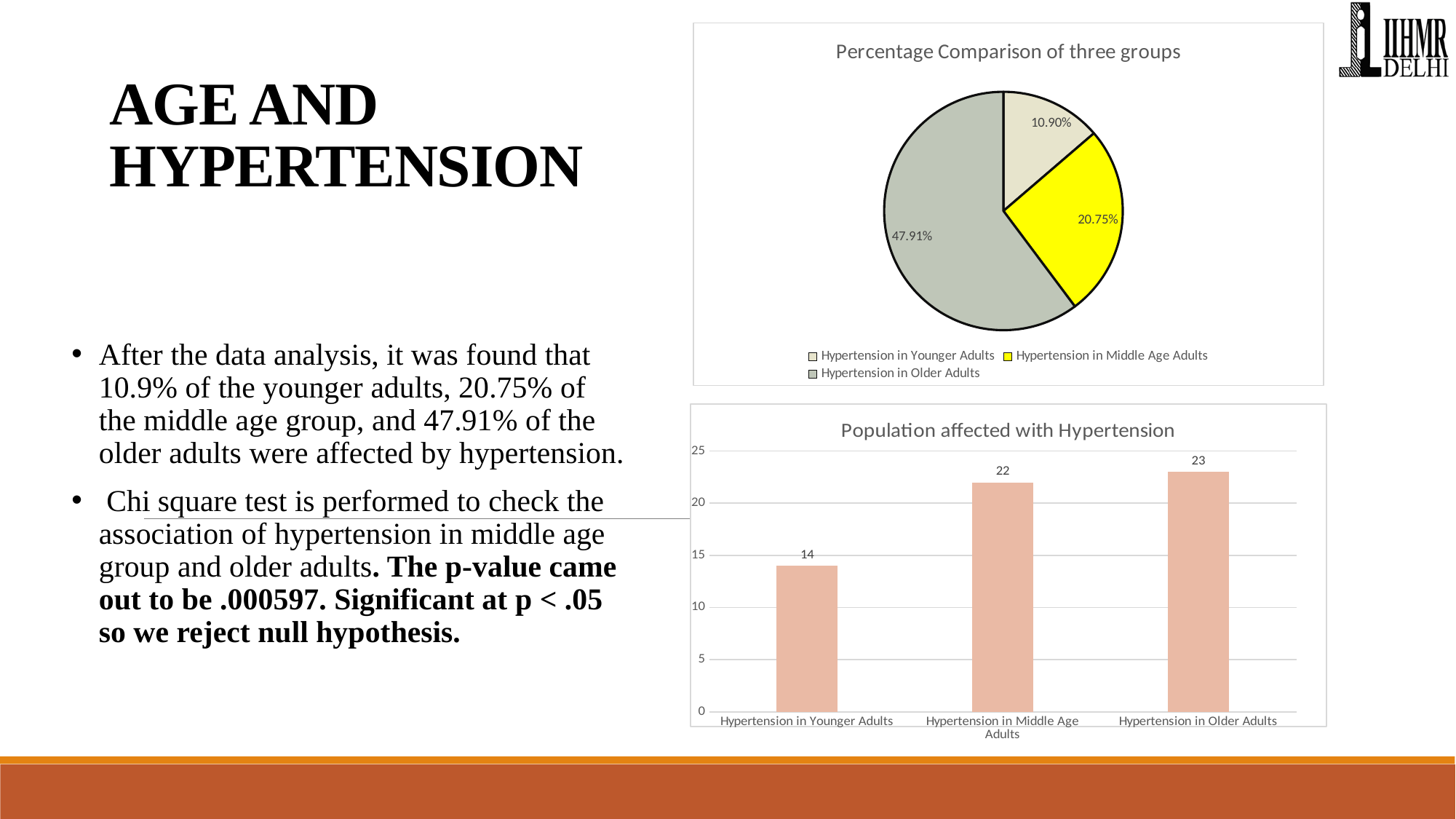
In the 'Population affected with Hypertension' chart, what is the value for Hypertension in Younger Adults? 14 In the 'Percentage Comparison of three groups' pie chart, how many entries does the legend list? 3 In the 'Percentage Comparison of three groups' pie chart, what percentage is shown for Hypertension in Younger Adults? 10.90% What kind of chart is 'Population affected with Hypertension'? Bar chart In the 'Percentage Comparison of three groups' pie chart, what percentage is shown for Hypertension in Older Adults? 47.91% In the 'Population affected with Hypertension' chart, do the values rise or fall from Younger Adults to Older Adults? Rise In the 'Population affected with Hypertension' chart, what is the difference between the values for Older Adults and Younger Adults? 9 In the 'Population affected with Hypertension' chart, what is the value for Hypertension in Middle Age Adults? 22 In the 'Percentage Comparison of three groups' pie chart, which group has the largest slice? Hypertension in Older Adults In the 'Population affected with Hypertension' chart, how many categories are shown on the x axis? 3 In the 'Percentage Comparison of three groups' chart, what colour is the slice for Hypertension in Middle Age Adults? Yellow In the 'Percentage Comparison of three groups' pie chart, which group has the smallest slice? Hypertension in Younger Adults